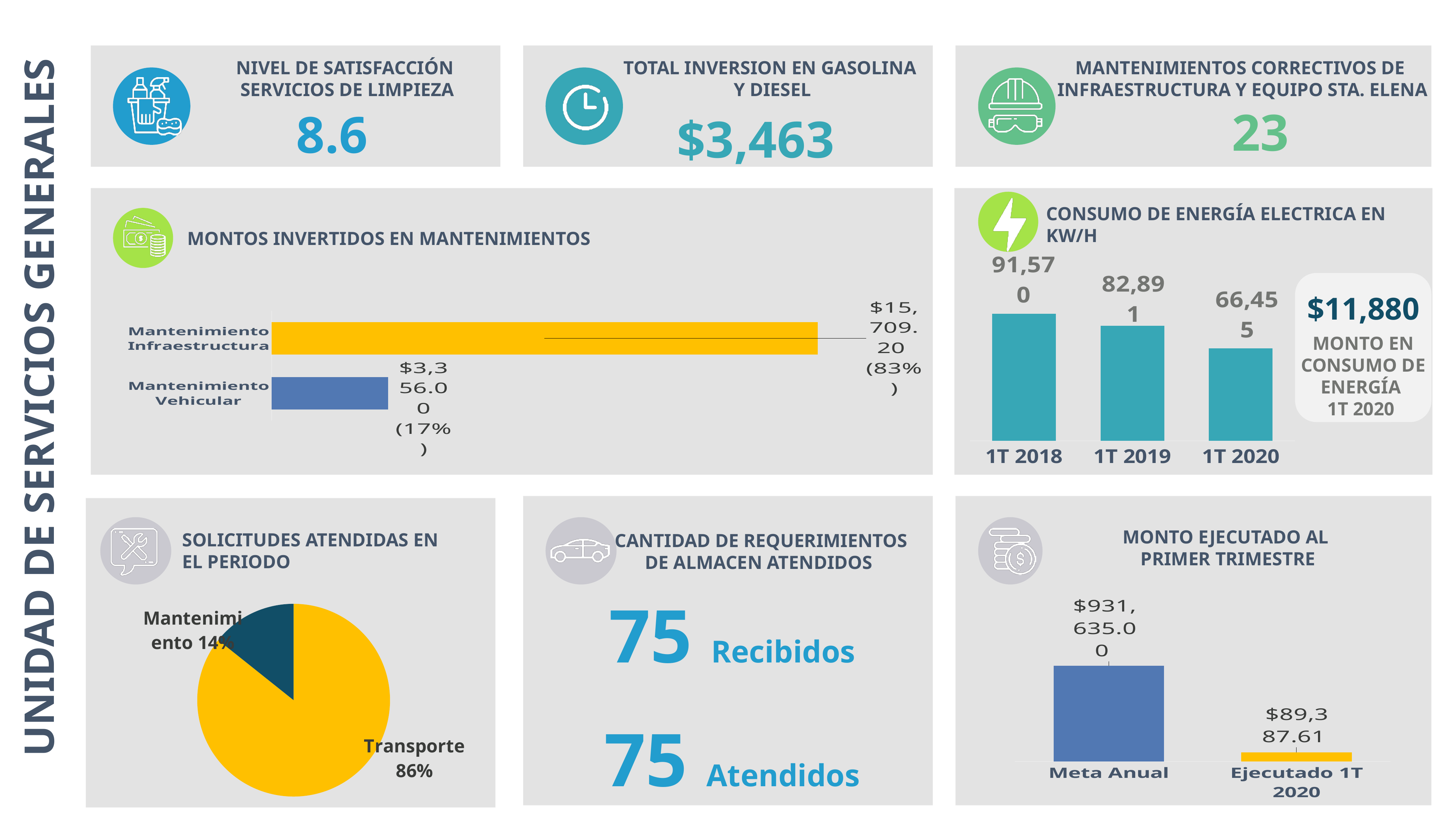
In the 'Montos invertidos en mantenimientos' chart, what is the value for Mantenimiento Vehicular? $3,356.00 In the 'Montos invertidos en mantenimientos' chart, what is the value for Mantenimiento Infraestructura? $15,709.20 In the 'Consumo de energía eléctrica en KW/H' chart, do the values rise or fall from 1T 2018 to 1T 2020? fall In the 'Monto ejecutado al primer trimestre' chart, which is larger, Meta Anual or Ejecutado 1T 2020? Meta Anual In the 'Consumo de energía eléctrica en KW/H' chart, how many periods are shown? 3 In the 'Solicitudes atendidas en el periodo' pie chart, what share does Transporte have? 86% In the 'Montos invertidos en mantenimientos' chart, what percentage share is shown for Mantenimiento Infraestructura? 83% What kind of chart is 'Montos invertidos en mantenimientos'? bar chart In the 'Consumo de energía eléctrica en KW/H' chart, which period has the lowest value? 1T 2020 In the 'Consumo de energía eléctrica en KW/H' chart, which period has the highest value? 1T 2018 In the 'Monto ejecutado al primer trimestre' chart, what is the value for Meta Anual? $931,635.00 In the 'Consumo de energía eléctrica en KW/H' chart, what is the value for 1T 2019? 82,891